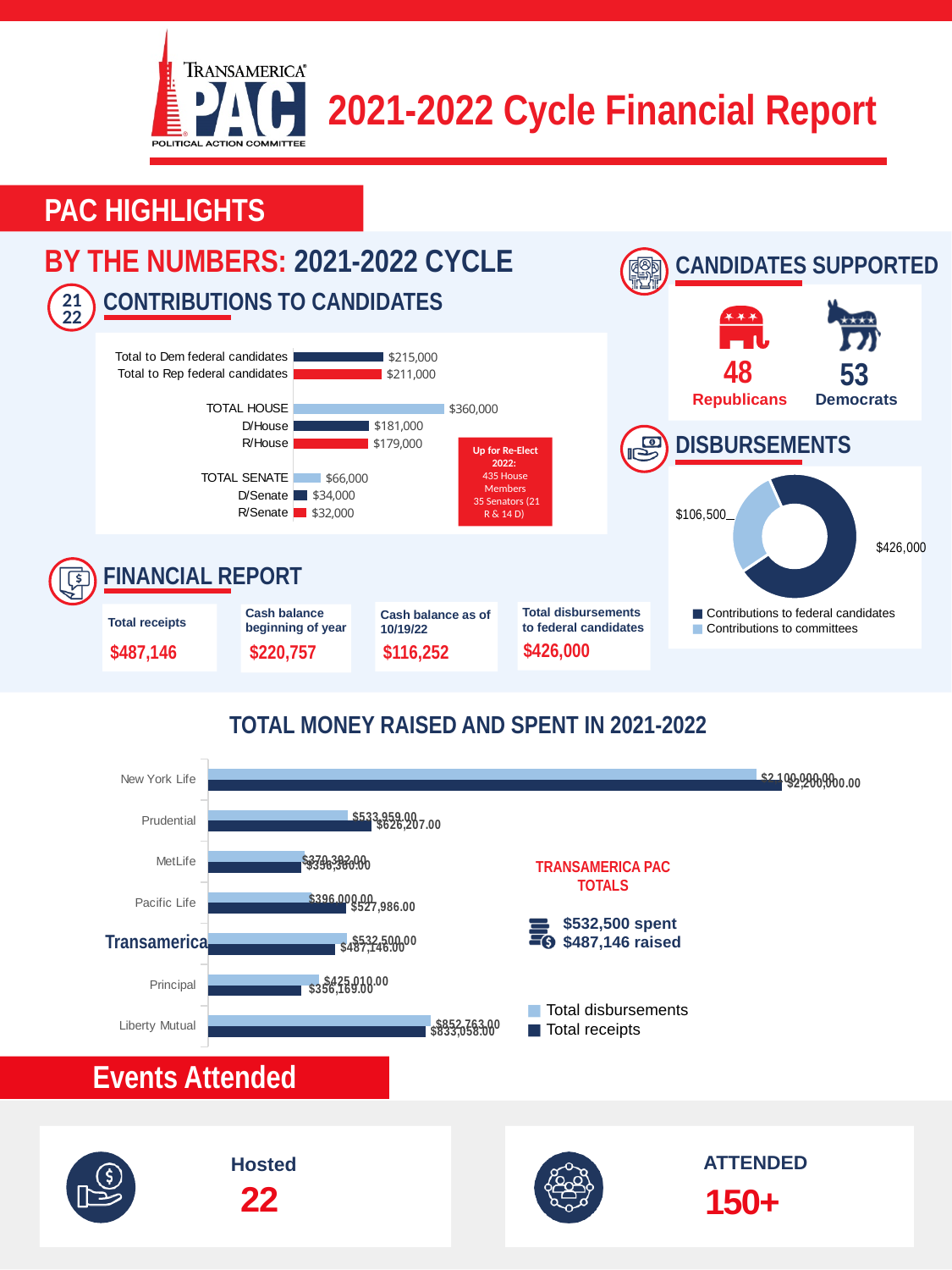
In the Disbursements chart, what share of the total is Contributions to federal candidates? 80% In the Contributions to Candidates chart, which is larger, TOTAL HOUSE or TOTAL SENATE? TOTAL HOUSE In the Total Money Raised and Spent in 2021-2022 chart, how many series does the legend list? 2 In the Total Money Raised and Spent in 2021-2022 chart, how many companies are listed? 7 In the Contributions to Candidates chart, what is the value for TOTAL HOUSE? $360,000 In the Contributions to Candidates chart, what is the difference between D/House and R/House? $2,000 What kind of chart is the Disbursements chart? Donut (pie) chart In the Contributions to Candidates chart, what is the value for Total to Dem federal candidates? $215,000 In the Total Money Raised and Spent in 2021-2022 chart, which company has the highest Total receipts? New York Life In the Total Money Raised and Spent in 2021-2022 chart, what are the Total receipts for Prudential? $626,207.00 In the Disbursements chart, what is the value for Contributions to committees? $106,500 In the Contributions to Candidates chart, which category has the lowest value? R/Senate